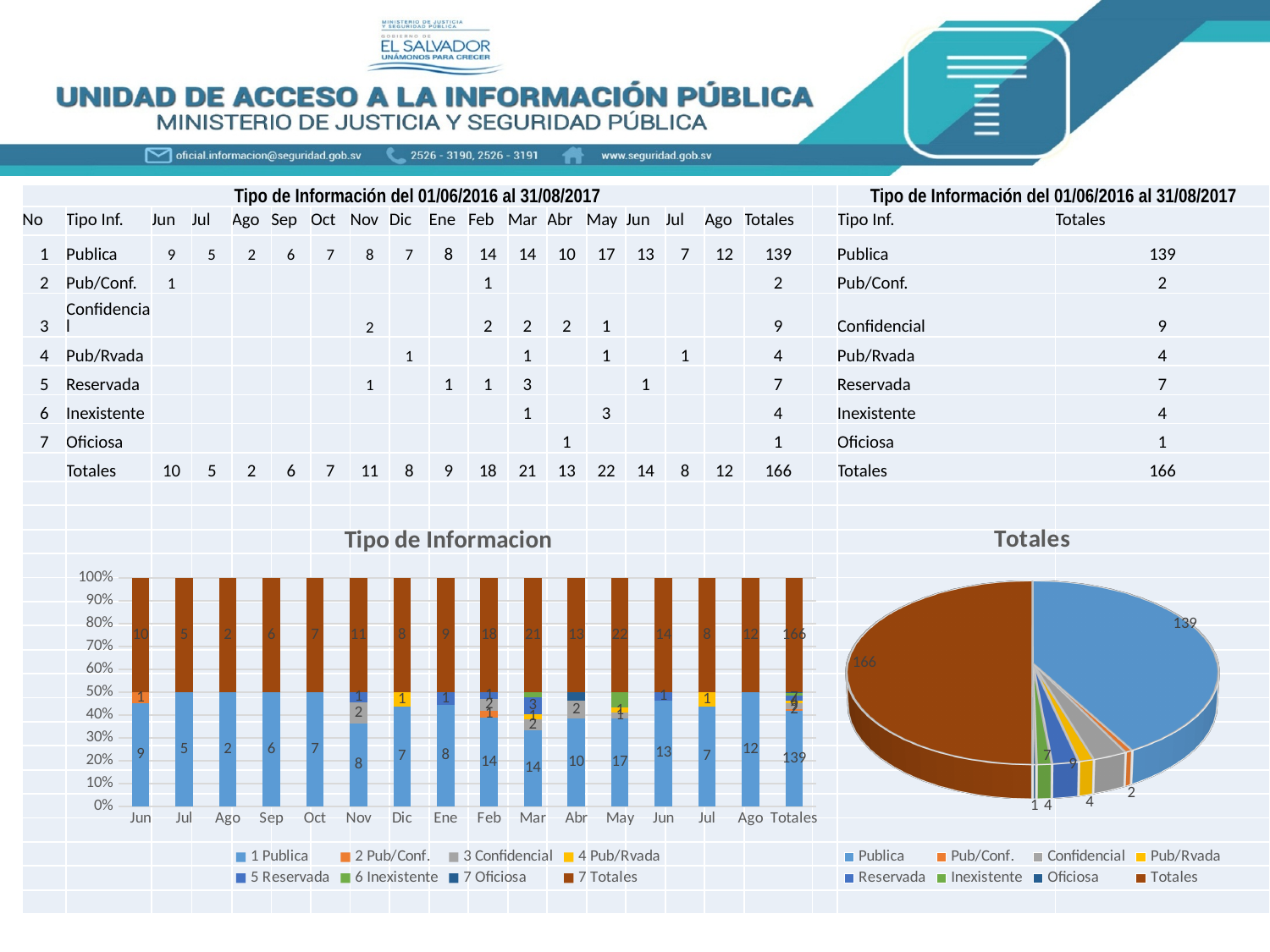
What kind of chart is the 'Tipo de Informacion' chart on the left? bar chart In the 'Tipo de Informacion' bar chart, what is the value of '7 Totales' for May? 22 In the 'Tipo de Informacion' bar chart, what is the value of '1 Publica' for the 'Totales' category? 139 In the 'Totales' pie chart, what is the difference between the Totales slice and the Publica slice? 27 In the 'Tipo de Informacion' bar chart, how many series does the legend list? 8 In the 'Totales' pie chart, how many entries does the legend list? 8 In the 'Tipo de Informacion' bar chart, what is the value of '7 Totales' for Mar? 21 In the 'Tipo de Informacion' bar chart, what is the value of '1 Publica' for Feb? 14 What kind of chart is the 'Totales' chart on the right? pie chart In the 'Tipo de Informacion' bar chart, how many categories are shown along the x axis? 16 In the 'Totales' pie chart, what is the value of the Publica slice? 139 In the 'Totales' pie chart, what is the value of the Totales slice? 166